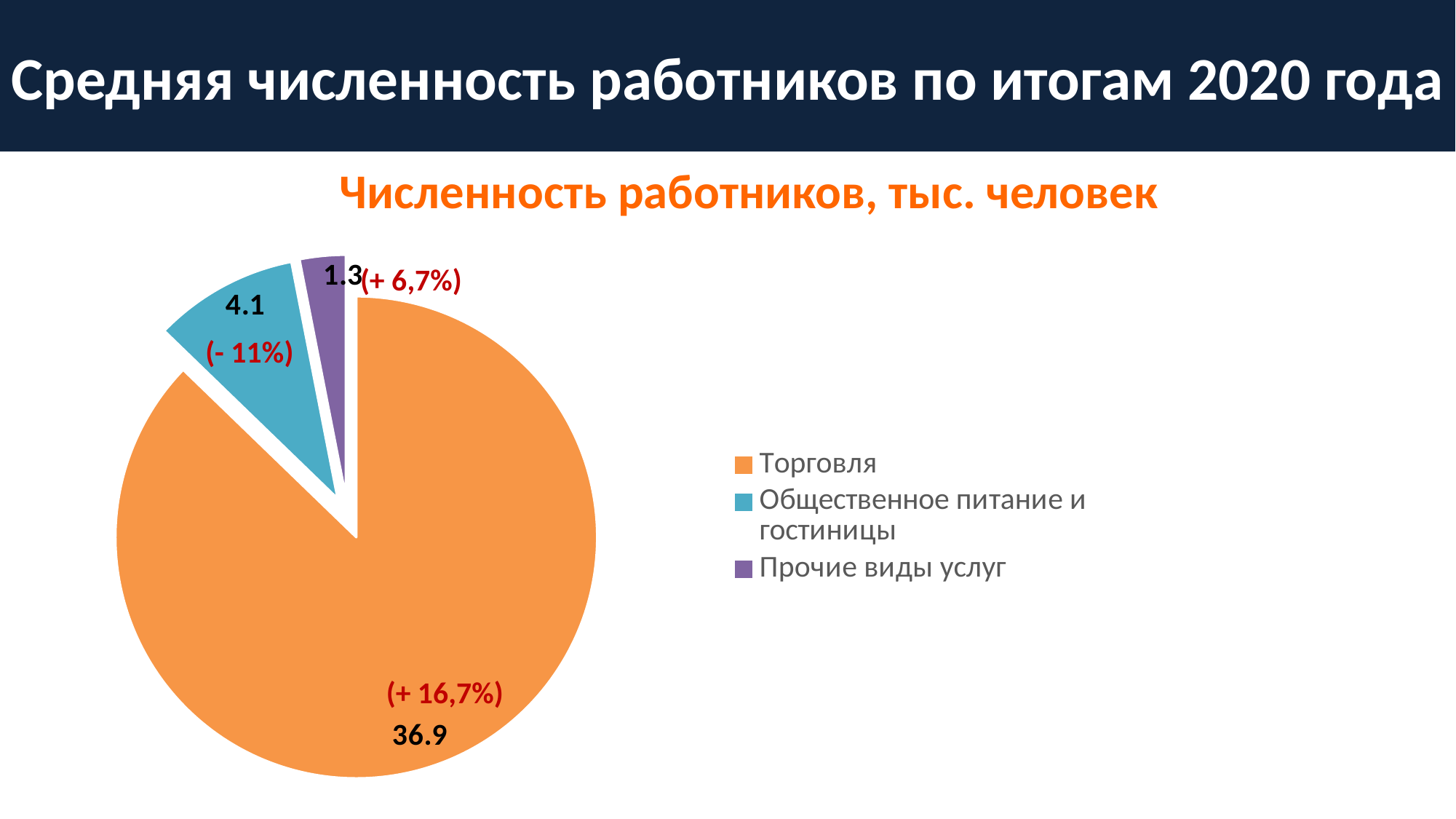
What is the difference between the values for Торговля and Общественное питание и гостиницы? 32.8 What is the value for Общественное питание и гостиницы in the pie chart? 4.1 Which is larger: the value for Общественное питание и гостиницы or the value for Прочие виды услуг? Общественное питание и гостиницы How many categories does the pie chart show? 3 What type of chart is shown on the slide? Pie chart What is the title of the chart? Численность работников, тыс. человек What is the value for Торговля in the pie chart? 36.9 What percentage change is shown in red next to the Торговля slice? (+ 16,7%) What is the value for Прочие виды услуг in the pie chart? 1.3 Which category has the smallest slice in the pie chart? Прочие виды услуг Which category has the largest slice in the pie chart? Торговля What is the difference between the values for Общественное питание и гостиницы and Прочие виды услуг? 2.8